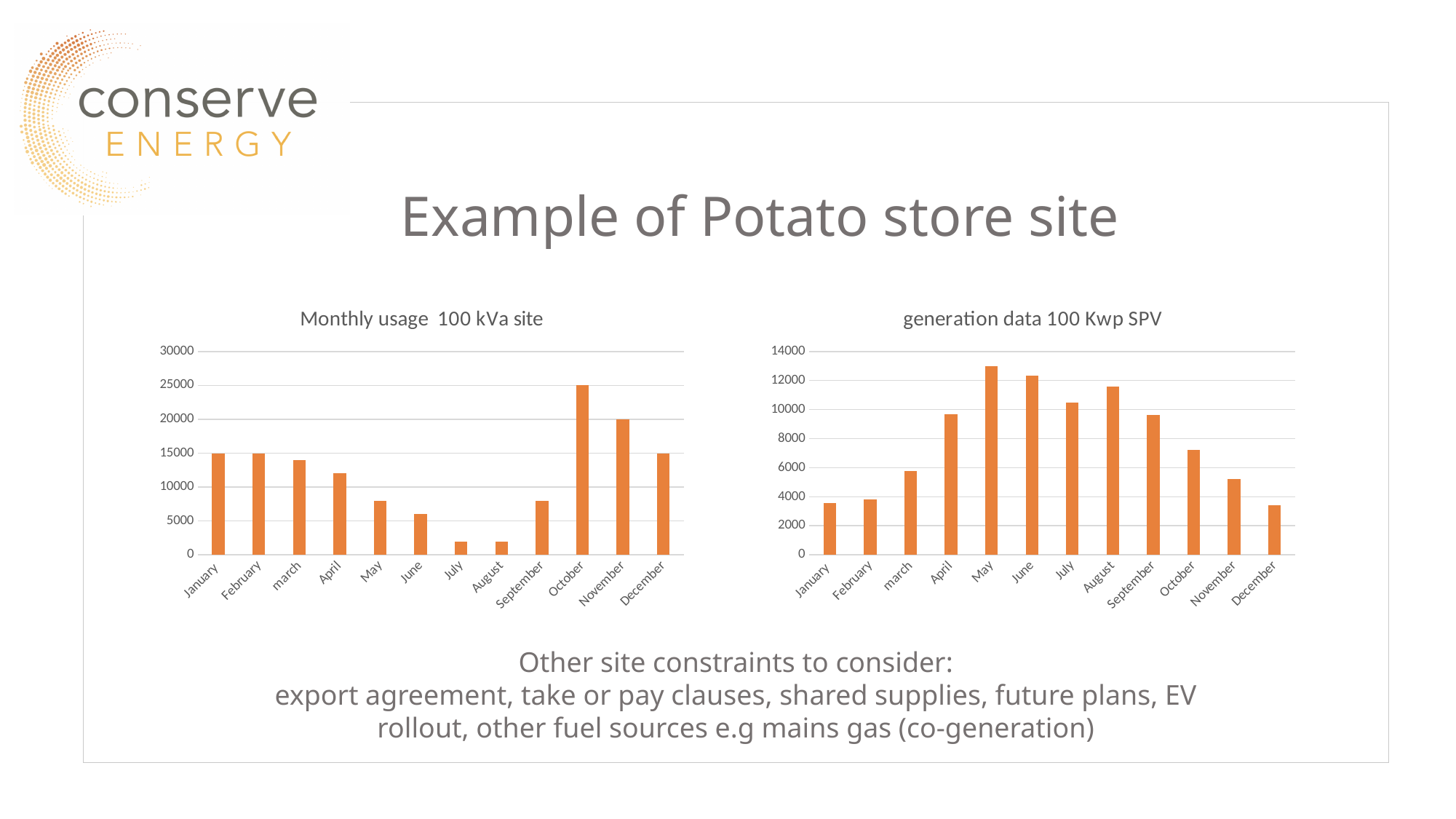
In the 'Monthly usage 100 kVa site' chart, is the value for July greater or less than 5000? less In the 'generation data 100 Kwp SPV' chart, do the values rise or fall from January to May? rise In the 'generation data 100 Kwp SPV' chart, which is larger, June or July? June In the 'generation data 100 Kwp SPV' chart, is the value for May greater or less than 12000? greater How many months are plotted in the 'generation data 100 Kwp SPV' chart? 12 In the 'Monthly usage 100 kVa site' chart, what is the value for October? 25000 In the 'Monthly usage 100 kVa site' chart, which month has the highest usage? October In the 'Monthly usage 100 kVa site' chart, is the value for April greater or less than 10000? greater In the 'Monthly usage 100 kVa site' chart, which is larger, October or November? October What kind of chart is the 'Monthly usage 100 kVa site' chart? bar chart In the 'generation data 100 Kwp SPV' chart, which month has the highest generation? May In the 'Monthly usage 100 kVa site' chart, what is the value for November? 20000